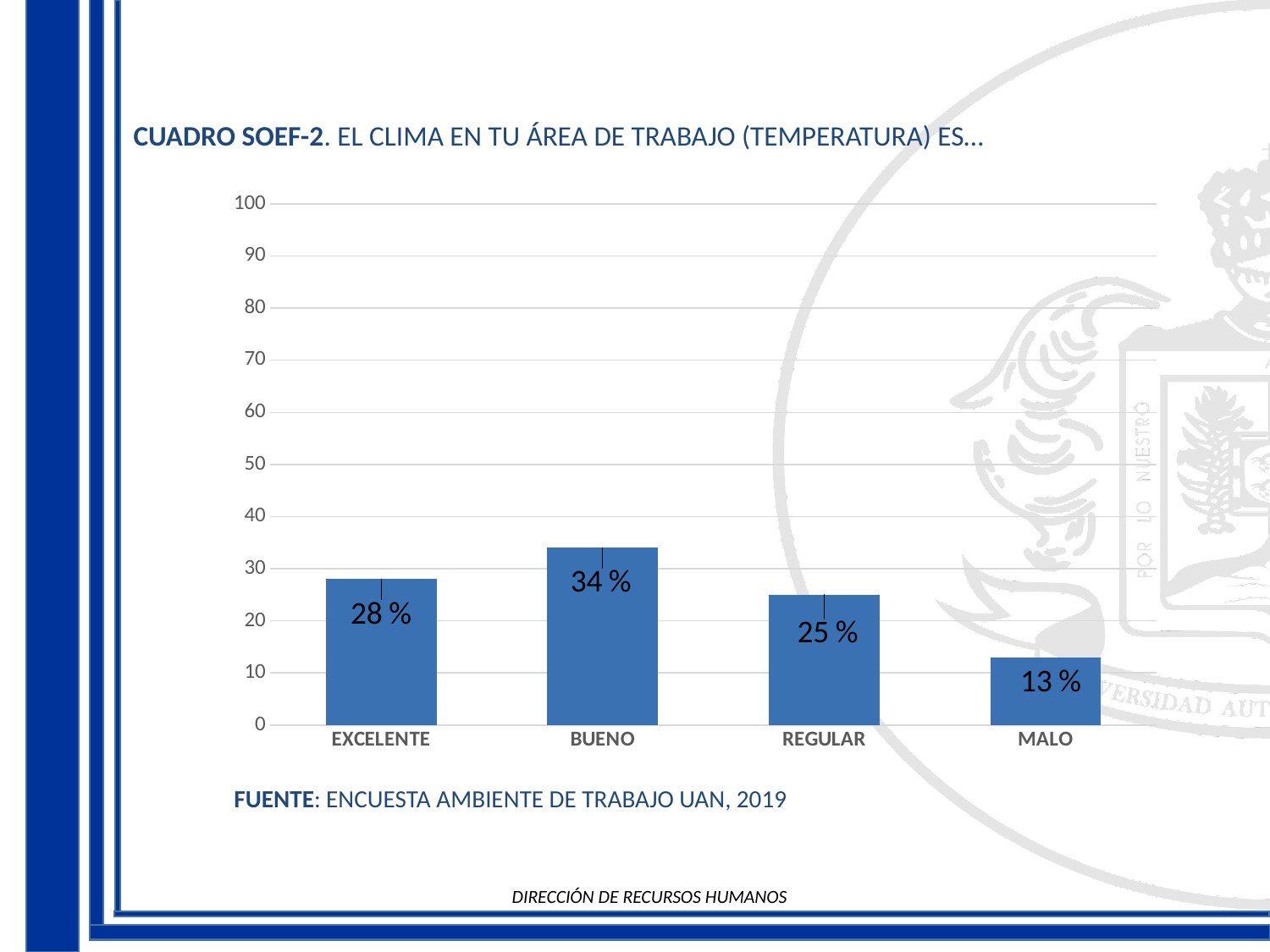
What kind of chart is shown on the slide? Bar chart How many categories are shown on the x axis? 4 Which category has the highest value? BUENO What is the highest value shown on the y axis? 100 Which category has the lowest value? MALO What is the source cited below the chart? ENCUESTA AMBIENTE DE TRABAJO UAN, 2019 Which is larger, the value for EXCELENTE or the value for REGULAR? EXCELENTE What is the value for BUENO? 34 % What is the difference between the values for BUENO and REGULAR? 9 % What is the value for MALO? 13 % What is the value for EXCELENTE? 28 % Is the value for BUENO greater or less than 30? greater